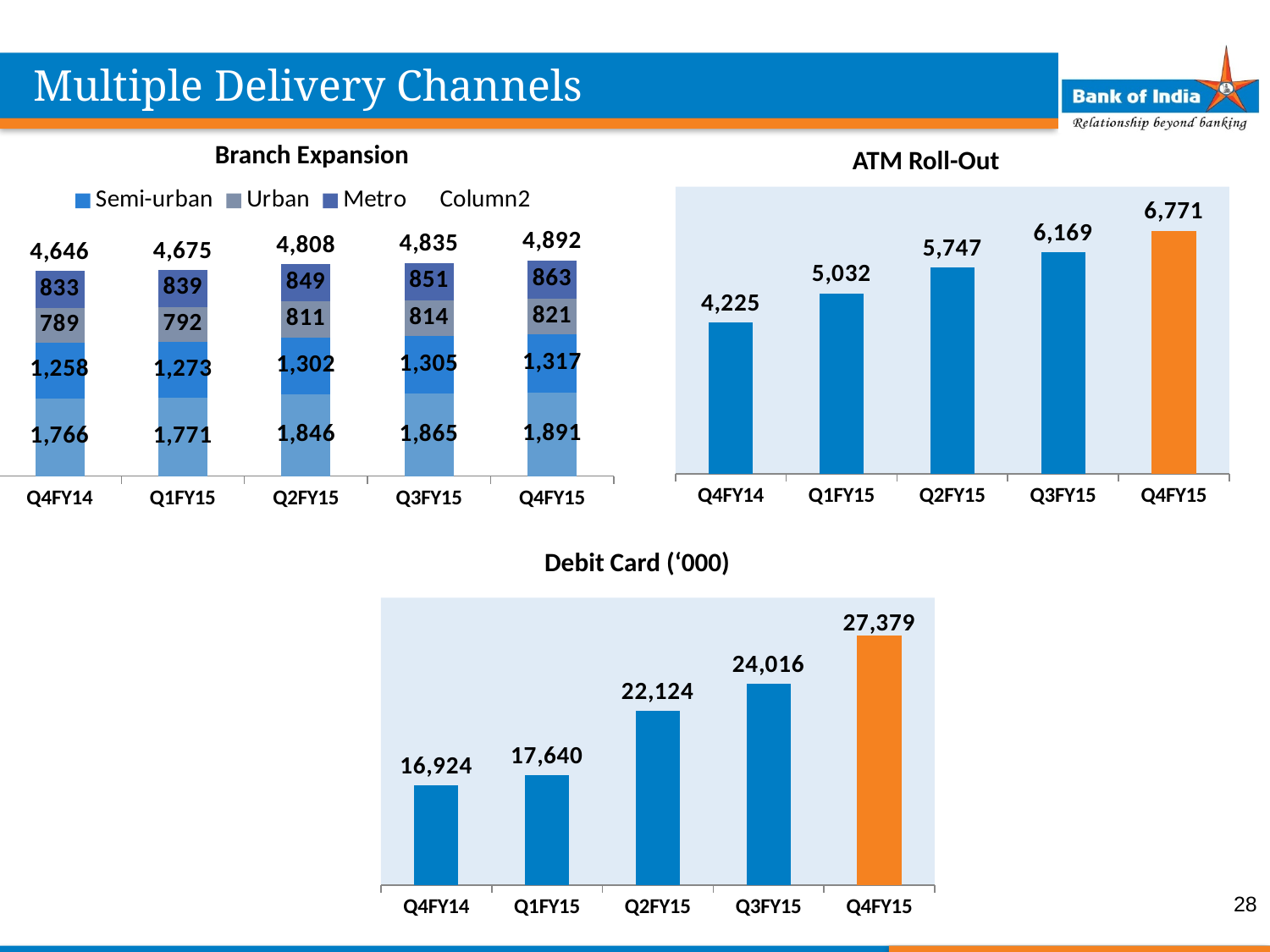
What kind of chart is the Debit Card ('000) chart? bar chart In the Debit Card ('000) chart, what is the value for Q2FY15? 22,124 How many entries does the legend of the Branch Expansion chart list? 4 In the ATM Roll-Out chart, which is larger, the value for Q2FY15 or Q1FY15? Q2FY15 In the ATM Roll-Out chart, what is the value for Q4FY14? 4,225 How many quarters are shown on the x axis of the Branch Expansion chart? 5 In the ATM Roll-Out chart, what is the difference between the Q4FY15 and Q4FY14 values? 2,546 In the Debit Card ('000) chart, which quarter has the lowest value? Q4FY14 In the ATM Roll-Out chart, which quarter has the highest value? Q4FY15 In the Branch Expansion chart, what is the total of the stacked bar for Q4FY15? 4,892 In the ATM Roll-Out chart, do the values rise or fall from Q4FY14 to Q4FY15? rise In the Debit Card ('000) chart, what is the difference between the Q4FY15 and Q3FY15 values? 3,363